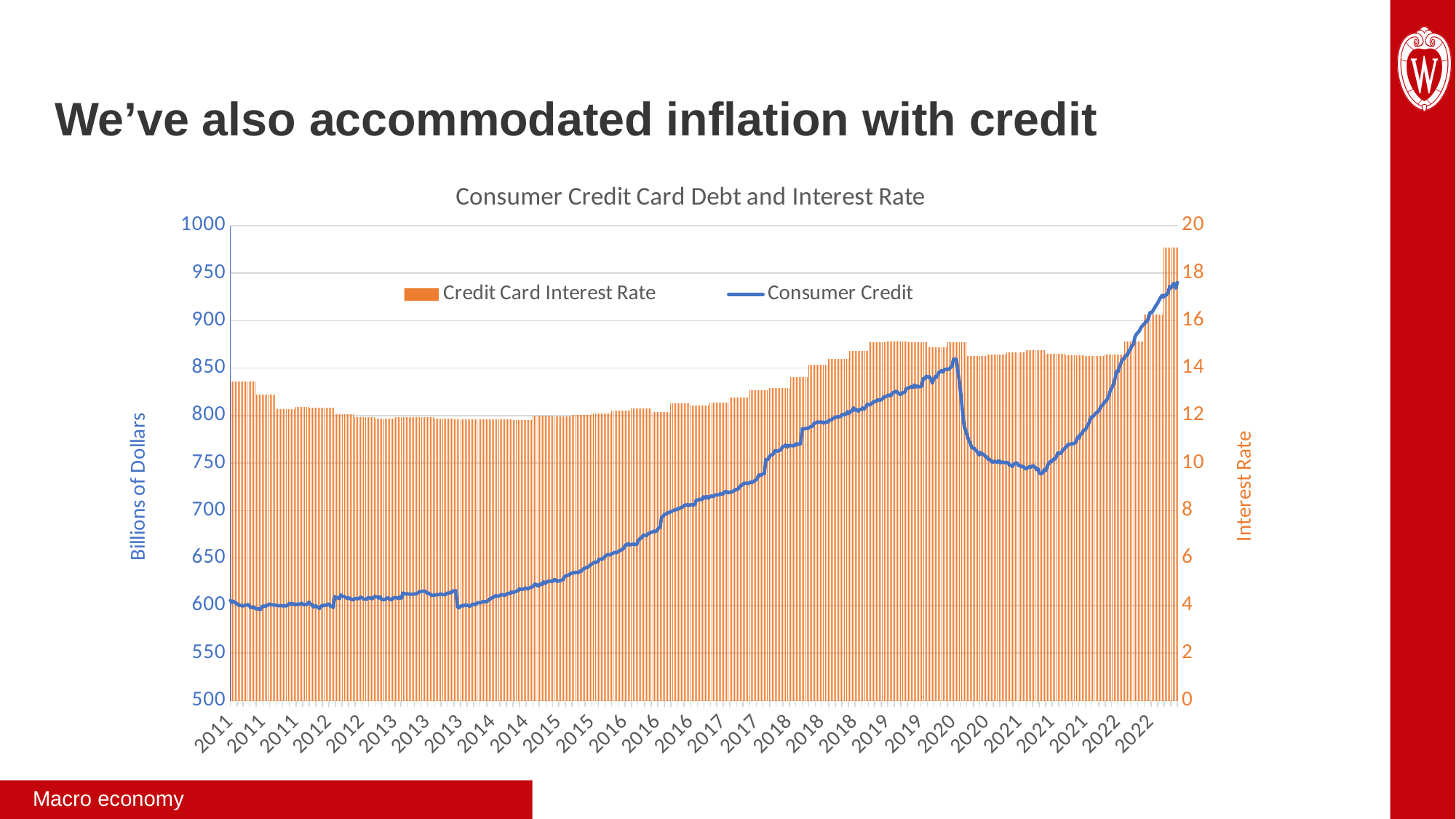
Does the Consumer Credit line overall rise or fall from 2011 to 2022? Rise Is the Consumer Credit value at the end of 2022 greater or less than 900? greater Is the Consumer Credit line higher in 2016 or in 2019? 2019 What is the label on the left vertical axis? Billions of Dollars What kind of chart is this? Combination bar and line chart Is the Consumer Credit value at the start of 2011 greater or less than 650? less What is the title of the chart? Consumer Credit Card Debt and Interest Rate How many series does the chart's legend list? 2 Is the Credit Card Interest Rate in 2014 greater or less than 14? less In which year does the Credit Card Interest Rate reach its highest level? 2022